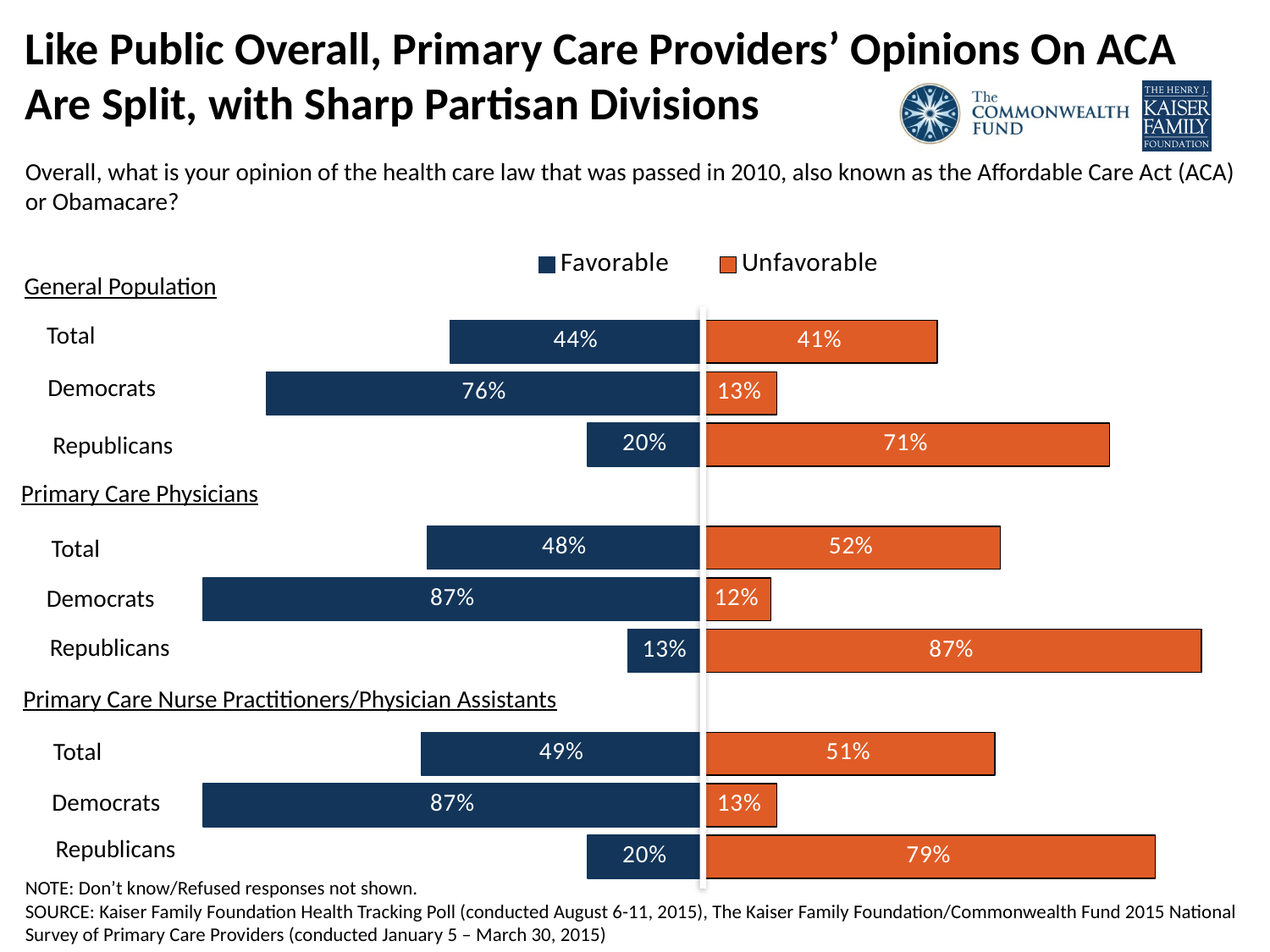
How many bars (category rows) are plotted on the chart? 9 What is the difference between the favorable and unfavorable values for Republicans among Primary Care Nurse Practitioners/Physician Assistants? 59 percentage points What colour represents the Unfavorable series? Orange What is the unfavorable value for Republicans among Primary Care Physicians? 87% Which group has the lowest favorable value on the chart? Primary Care Physicians Republicans Which group has the highest unfavorable value on the chart? Primary Care Physicians Republicans What is the unfavorable value for Republicans in the General Population? 71% What is the favorable value for Democrats among Primary Care Nurse Practitioners/Physician Assistants? 87% What percentage of the General Population Total has a favorable opinion of the ACA? 44% How many series does the legend list? 2 Is the favorable value larger for General Population Democrats or Primary Care Physicians Democrats? Primary Care Physicians Democrats What type of chart is shown on the slide? Bar chart